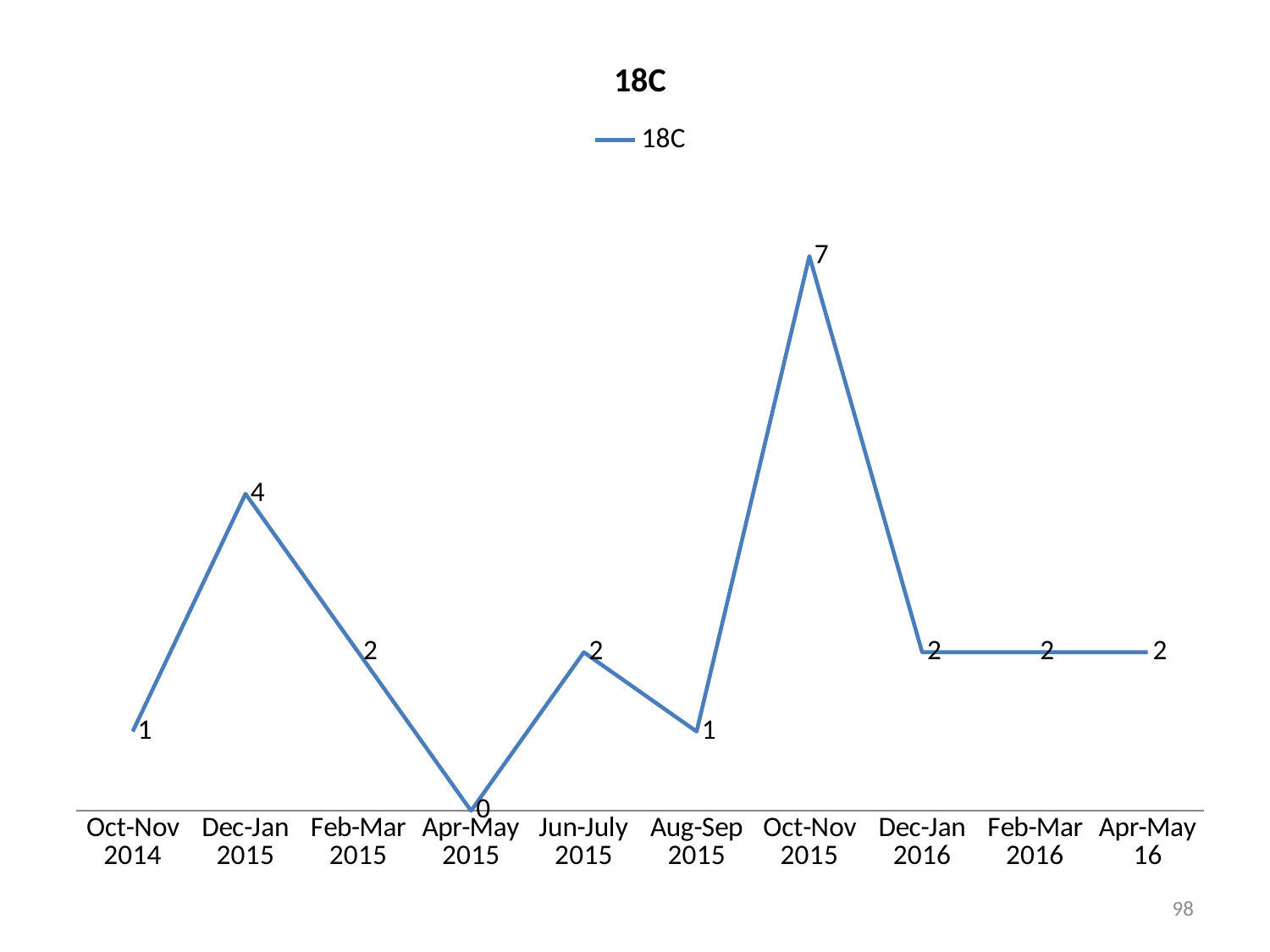
What is the difference between the values for Oct-Nov 2015 and Dec-Jan 2016? 5 What is the value for Aug-Sep 2015? 1 What is the value for Dec-Jan 2015? 4 How many periods are plotted on the x axis? 10 How many series does the legend list? 1 Which is larger, the value for Dec-Jan 2015 or the value for Jun-July 2015? Dec-Jan 2015 Which period has the highest value? Oct-Nov 2015 What is the value for Oct-Nov 2015? 7 What kind of chart is shown? line chart Which period has the lowest value? Apr-May 2015 What is the value for Apr-May 2015? 0 What is the title of the chart? 18C